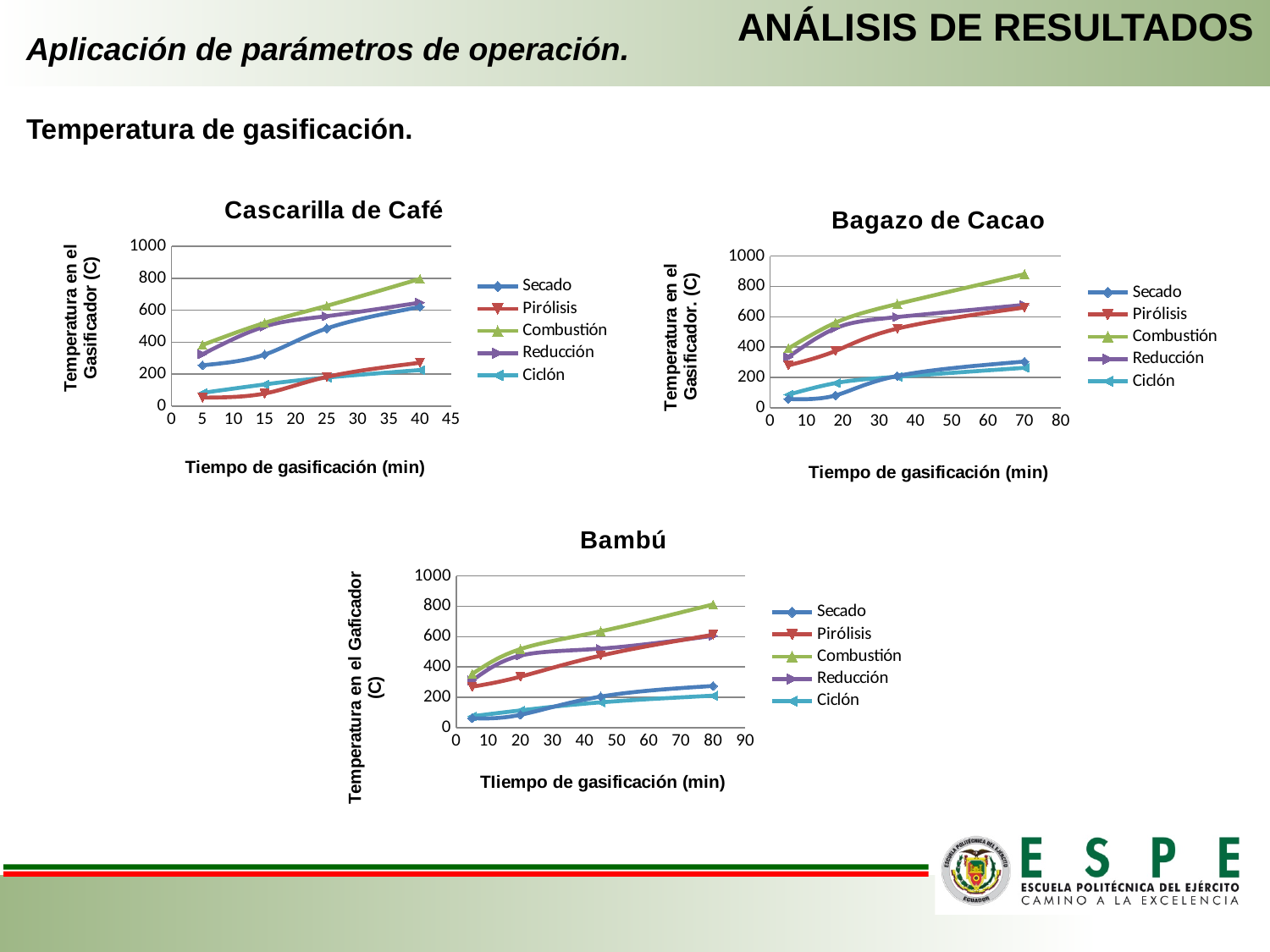
In the Bambú chart, does the Combustión series rise or fall as gasification time increases? rise In the Cascarilla de Café chart, which series reaches the highest temperature? Combustión How many data points does the Secado series have in the Cascarilla de Café chart? 4 In the Cascarilla de Café chart, is the Combustión value at 40 min greater or less than 600? greater In the Bambú chart, which series reaches the highest temperature? Combustión In the Bagazo de Cacao chart, which is larger at 70 min, Combustión or Secado? Combustión What kind of chart is the Cascarilla de Café chart? line chart In the Cascarilla de Café chart, is the Pirólisis value at 5 min greater or less than 200? less How many series does the legend of the Bagazo de Cacao chart list? 5 In the Bagazo de Cacao chart, is the Combustión value at 70 min greater or less than 800? greater What is the x-axis label of the Bagazo de Cacao chart? Tiempo de gasificación (min)